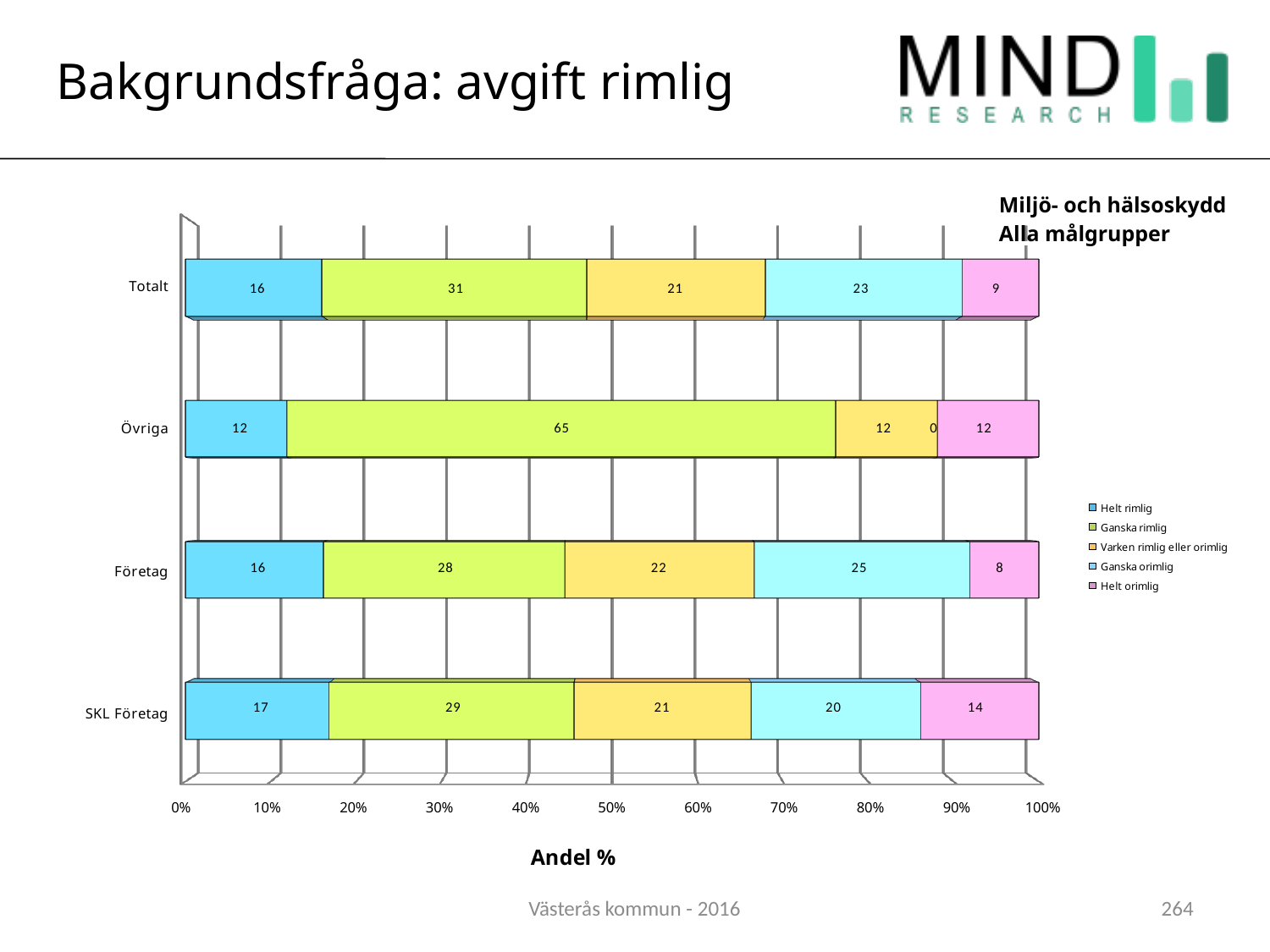
What is the difference between the 'Ganska rimlig' values for Övriga and Totalt? 34 What is the value of 'Ganska orimlig' for Övriga? 0 What is the label of the horizontal axis? Andel % How many series does the legend list? 5 What is the value of 'Ganska rimlig' for Övriga? 65 Which category has the lowest value for 'Helt orimlig'? Företag How many categories are shown on the vertical axis of the chart? 4 What is the value of 'Helt orimlig' for SKL Företag? 14 Which category has the highest value for 'Ganska rimlig'? Övriga What is the value of 'Ganska orimlig' for Företag? 25 Which is larger: the 'Helt rimlig' value for SKL Företag or for Totalt? SKL Företag What type of chart is shown on the slide? Stacked bar chart